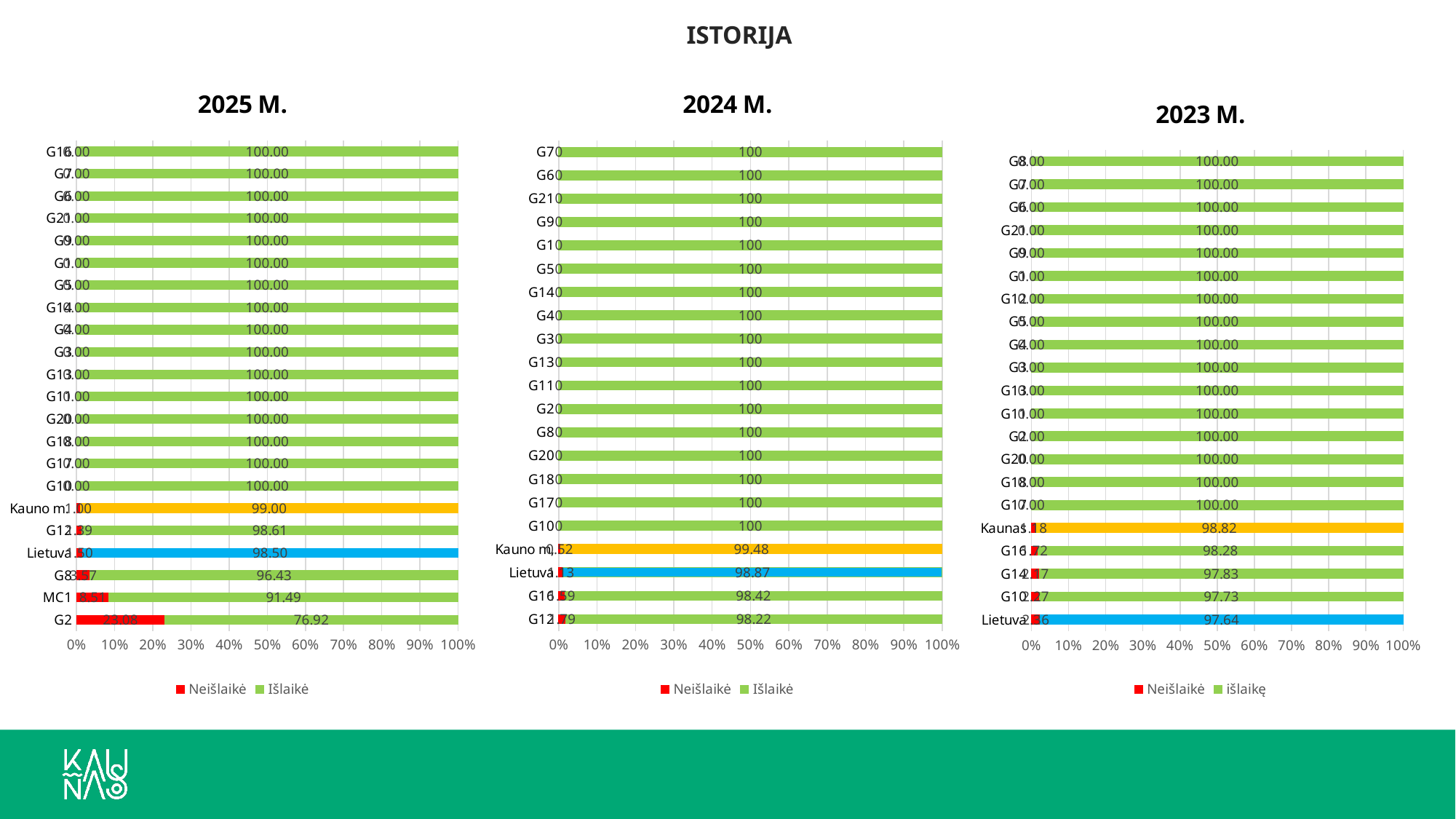
In the 2024 M. chart, what is the Išlaikė value for Lietuva? 98.87 In the 2023 M. chart, what is the Išlaikė value for Kaunas? 98.82 What kind of chart is the 2024 M. chart? Bar chart In the 2025 M. chart, what is the Išlaikė value for MC1? 91.49 In the 2025 M. chart, what is the Neišlaikė value for G2? 23.08 In the 2025 M. chart, what is the Išlaikė value for G2? 76.92 In the 2023 M. chart, which category has the lowest Išlaikė value? Lietuva How many series does the legend of the 2025 M. chart list? 2 In the 2025 M. chart, what is the difference between the Išlaikė values of MC1 and G2? 14.57 In the 2024 M. chart, what is the Išlaikė value for Kauno m.? 99.48 In the 2025 M. chart, which has the larger Išlaikė value, G8 or MC1? G8 In the 2025 M. chart, which category has the lowest Išlaikė value? G2